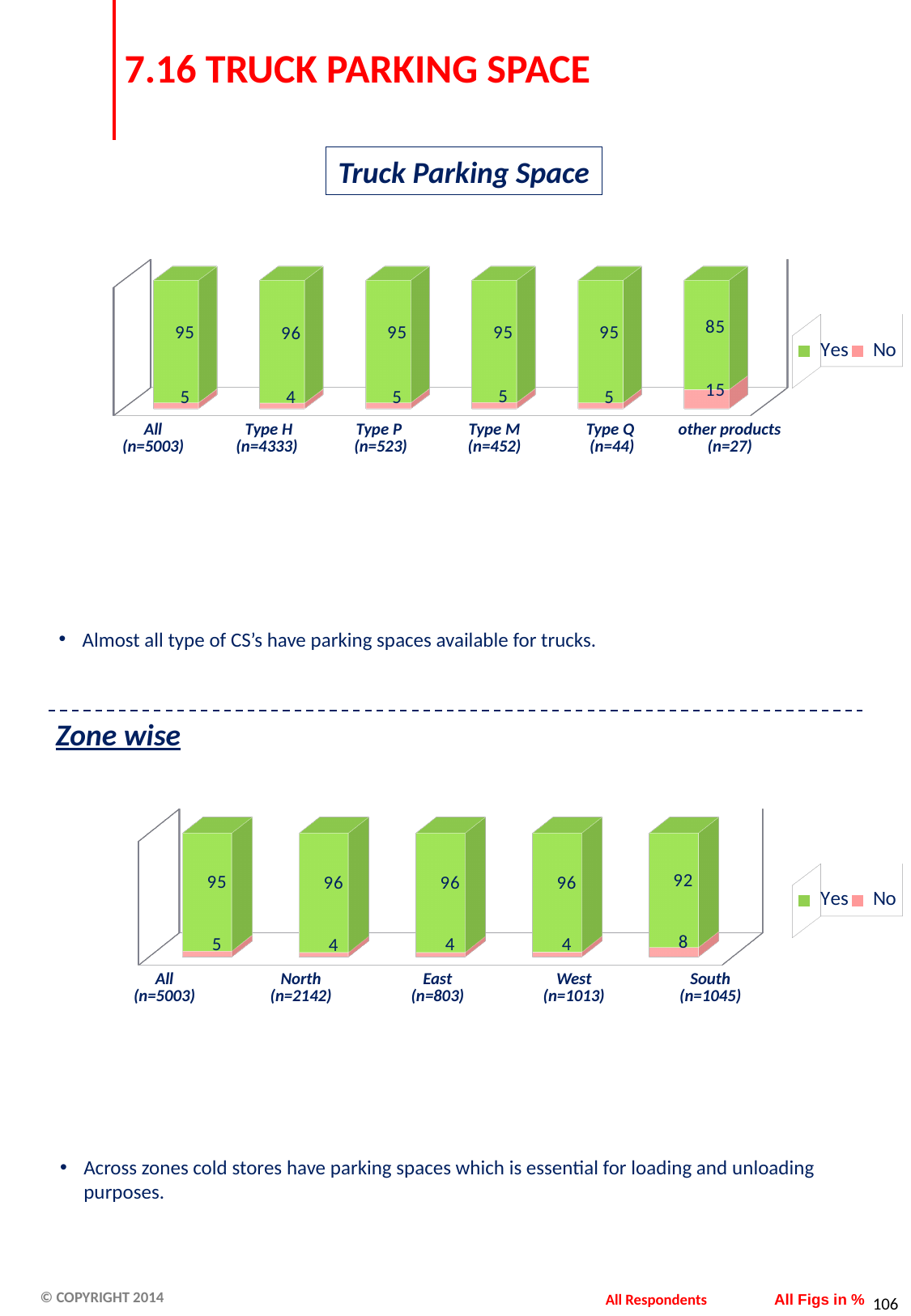
In the top 'Truck Parking Space' chart, what is the difference between the 'Yes' values for Type H and other products? 11 In the top 'Truck Parking Space' chart, which category has the lowest 'Yes' value? other products (n=27) In the top 'Truck Parking Space' chart, how many categories are shown on the x axis? 6 In the bottom 'Zone wise' chart, which zone has the highest 'No' value? South (n=1045) What kind of chart is the bottom 'Zone wise' chart? Stacked bar chart In the bottom 'Zone wise' chart, how many series does the legend list? 2 In the top 'Truck Parking Space' chart, what is the 'No' value for other products (n=27)? 15 In the top 'Truck Parking Space' chart, what is the total of the stacked bar for Type Q (n=44)? 100 In the top 'Truck Parking Space' chart, what is the 'Yes' value for Type H (n=4333)? 96 In the bottom 'Zone wise' chart, what is the 'Yes' value for South (n=1045)? 92 In the bottom 'Zone wise' chart, is the 'Yes' value for East larger or smaller than the 'Yes' value for South? larger In the bottom 'Zone wise' chart, what is the 'No' value for North (n=2142)? 4